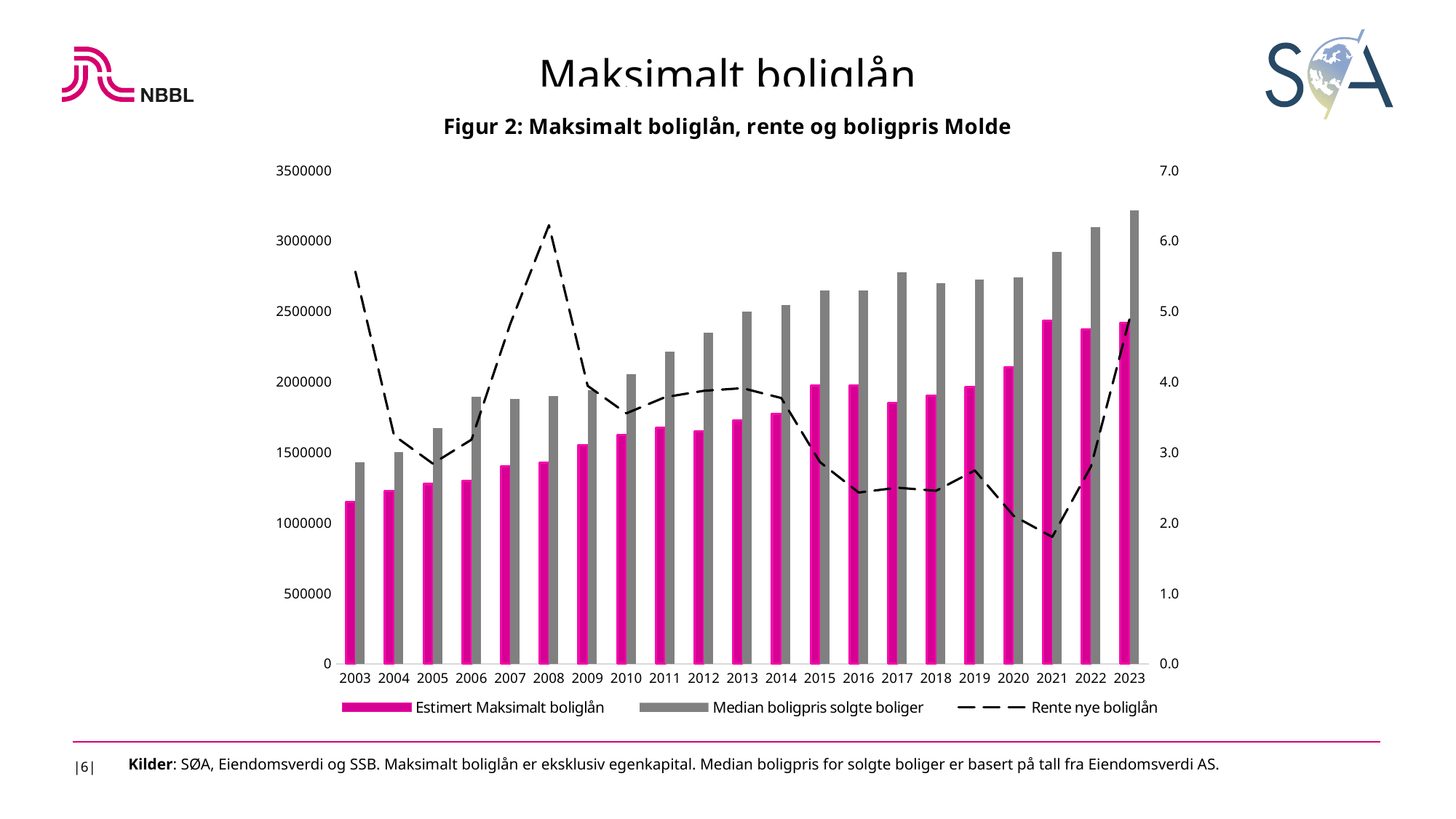
What kind of chart is shown on the slide? bar chart with a dashed line In which year does Rente nye boliglån reach its highest value? 2008 In 2023, which is larger: Estimert Maksimalt boliglån or Median boligpris solgte boliger? Median boligpris solgte boliger In which year is Median boligpris solgte boliger lowest? 2003 How many series does the legend list? 3 Is the value for Median boligpris solgte boliger in 2023 greater or less than 3000000? greater How many years are shown on the x axis? 21 What is the title of the figure? Figur 2: Maksimalt boliglån, rente og boligpris Molde Is the value for Rente nye boliglån in 2021 greater or less than 2.0? less Is the value for Estimert Maksimalt boliglån in 2003 greater or less than 1500000? less In which year is Estimert Maksimalt boliglån lowest? 2003 In which year is Median boligpris solgte boliger highest? 2023